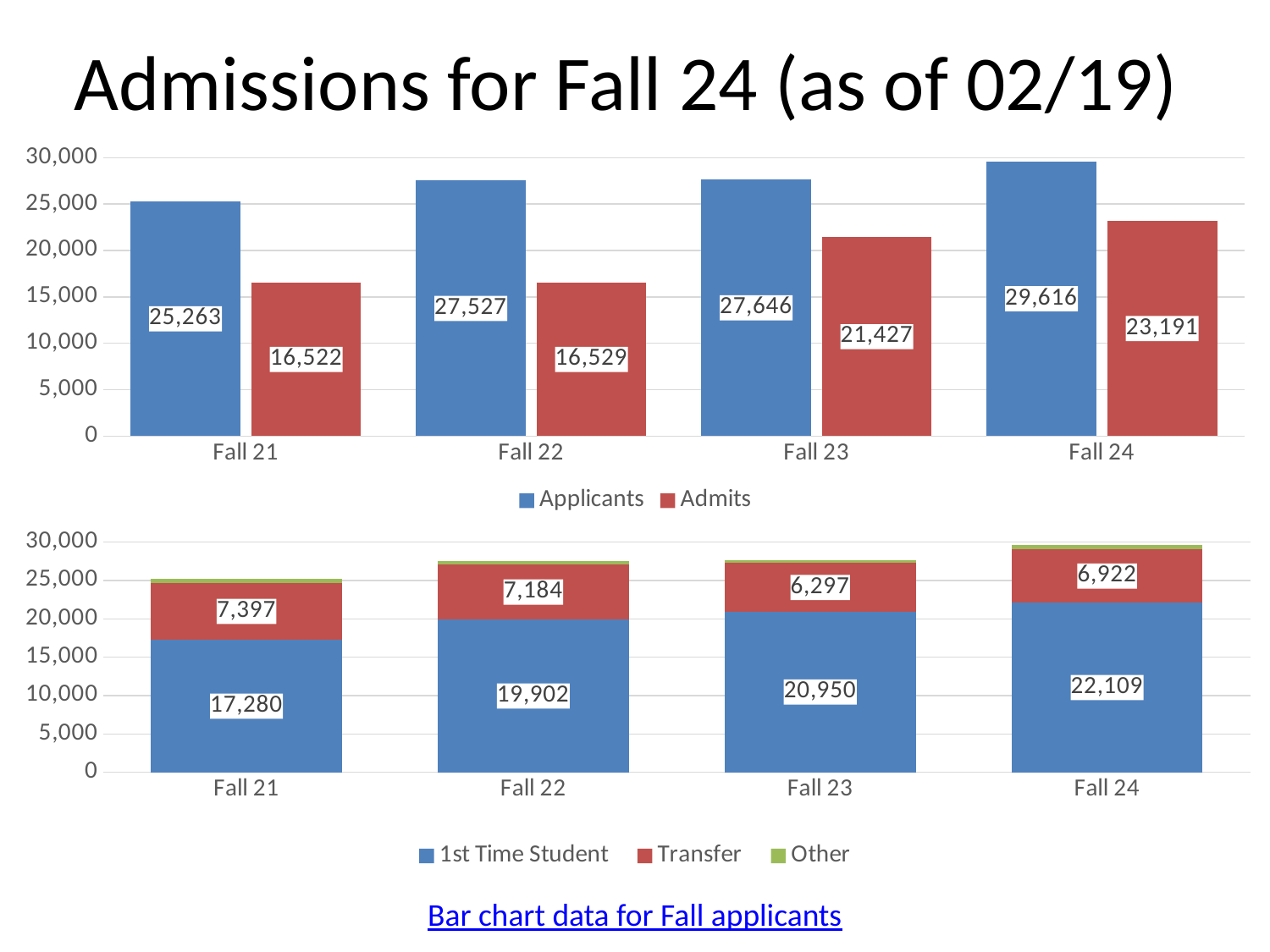
In the top chart, what is the number of Admits for Fall 22? 16,529 In the bottom chart, what is the number of Transfer applicants for Fall 21? 7,397 In the top chart, what is the number of Applicants for Fall 24? 29,616 In the bottom chart, which Fall term has the lowest number of Transfer applicants? Fall 23 In the bottom chart, what is the number of 1st Time Student applicants for Fall 23? 20,950 In the top chart, do the Admits values rise or fall from Fall 22 to Fall 24? rise In the bottom chart, is the Transfer value for Fall 22 larger or smaller than the Transfer value for Fall 24? larger In the top chart, which Fall term has the lowest number of Applicants? Fall 21 In the top chart, how many series does the legend list? 2 What kind of chart is the bottom chart? stacked bar chart In the top chart, what is the difference between Applicants and Admits for Fall 23? 6,219 In the top chart, which Fall term has the highest number of Applicants? Fall 24